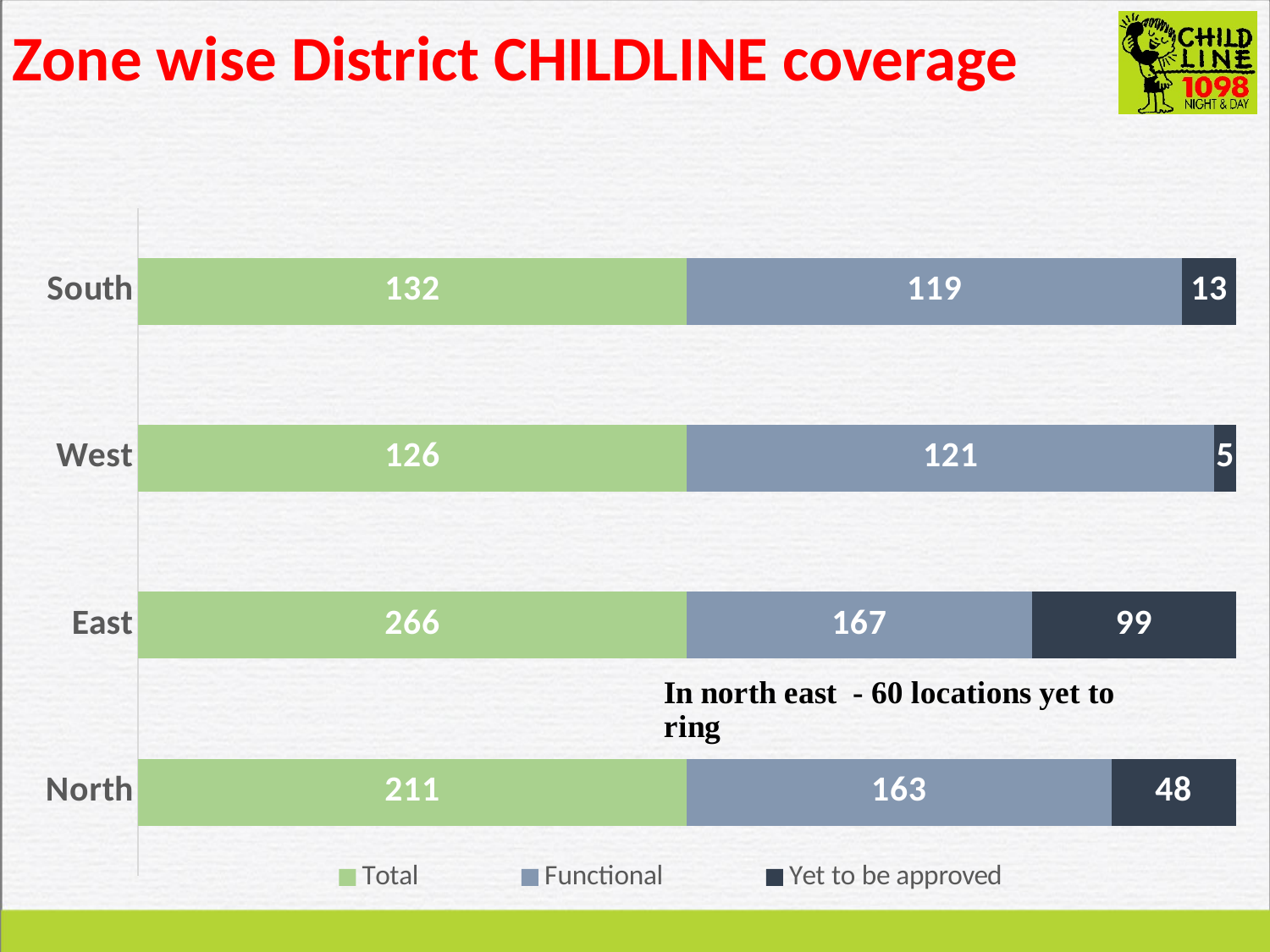
What kind of chart is shown on the slide? Stacked bar chart Which zone has the lowest Yet to be approved value? West Which zone has the larger Functional value, South or West? West What is the Functional value for the South zone? 119 How much larger is the Yet to be approved value for East than for North? 51 What is the difference between the Total and Functional values for the South zone? 13 Which zone has the highest Total value? East What is the Functional value for the North zone? 163 What is the Yet to be approved value for the West zone? 5 How many series does the legend list? 3 What is the Total value for the East zone? 266 How many zones are shown in the chart? 4